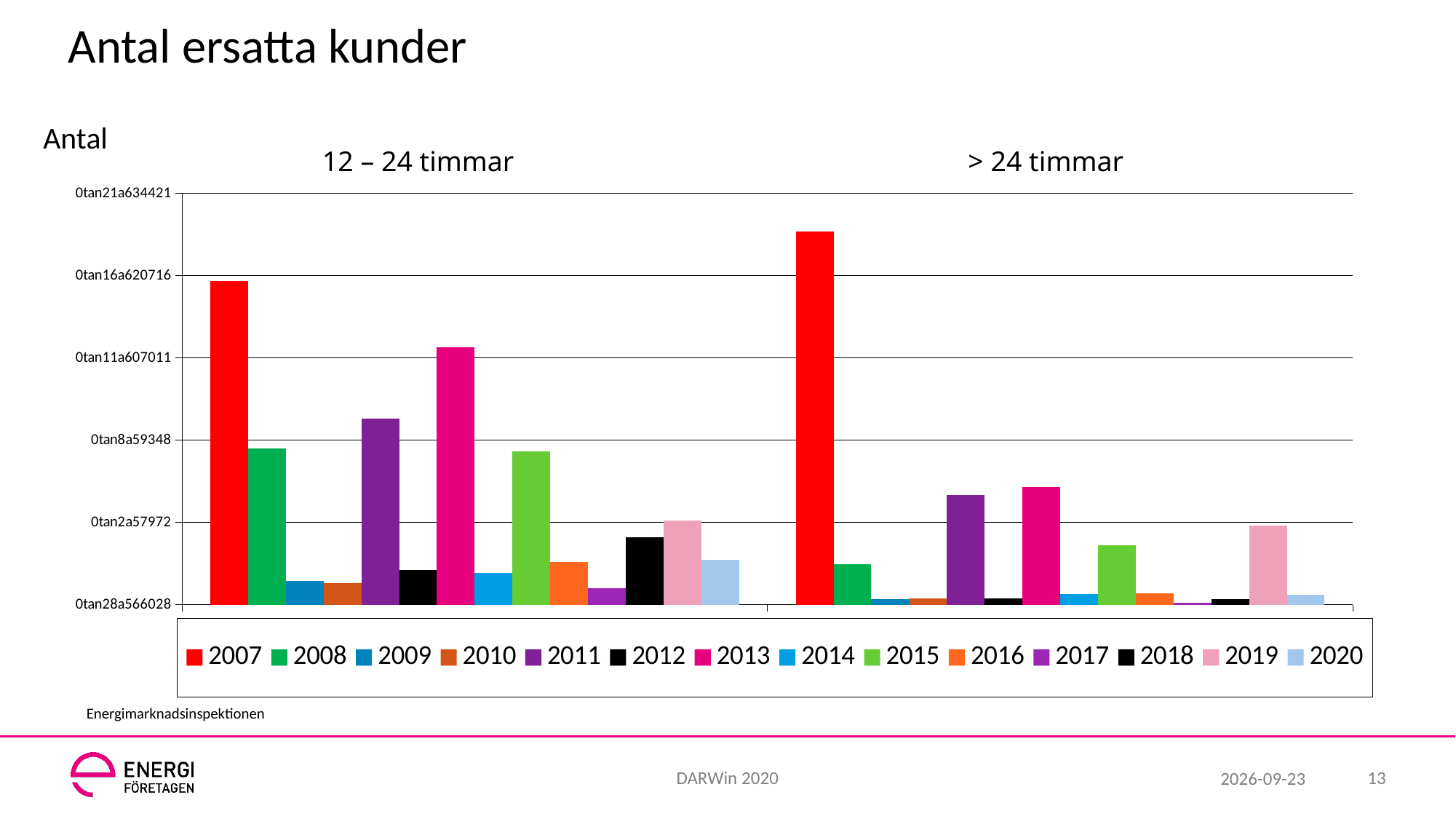
How many category groups are shown on the x axis? 2 Is the 2015 bar larger in the "12 – 24 timmar" group or in the "> 24 timmar" group? 12 – 24 timmar What is the title of the chart? Antal ersatta kunder In the "12 – 24 timmar" group, which year has the highest bar? 2007 What colour is used for the 2007 series in the legend? red In the "12 – 24 timmar" group, which is larger, the bar for 2019 or the bar for 2020? 2019 In the "12 – 24 timmar" group, which year has the lowest bar? 2017 In the "> 24 timmar" group, which year has the highest bar? 2007 In the "12 – 24 timmar" group, which is larger, the bar for 2011 or the bar for 2013? 2013 How many series does the legend list? 14 What kind of chart is shown on the slide? bar chart